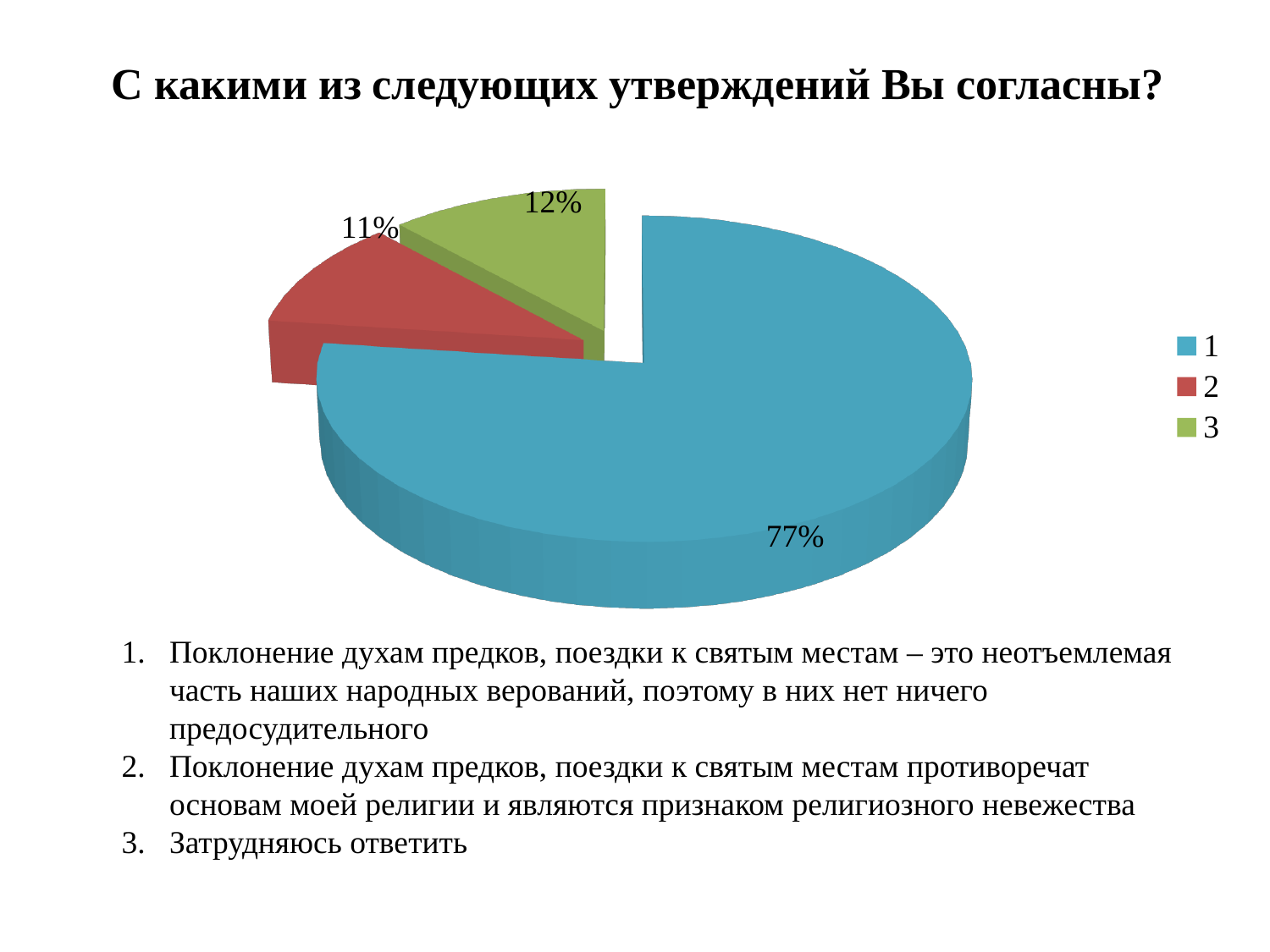
Which category has the smallest slice of the pie? 2 How many slices does the pie chart have? 3 How many entries does the legend list? 3 What share of the pie does category 3 have? 12% What share of the pie does category 2 have? 11% What share of the pie does category 1 have? 77% Which category has the largest slice of the pie? 1 What colour is the slice for category 2? red What is the difference in percentage points between category 1 and category 3? 65 What kind of chart is shown on the slide? pie chart What is the difference in percentage points between category 3 and category 2? 1 Which is larger, the slice for category 2 or the slice for category 3? 3